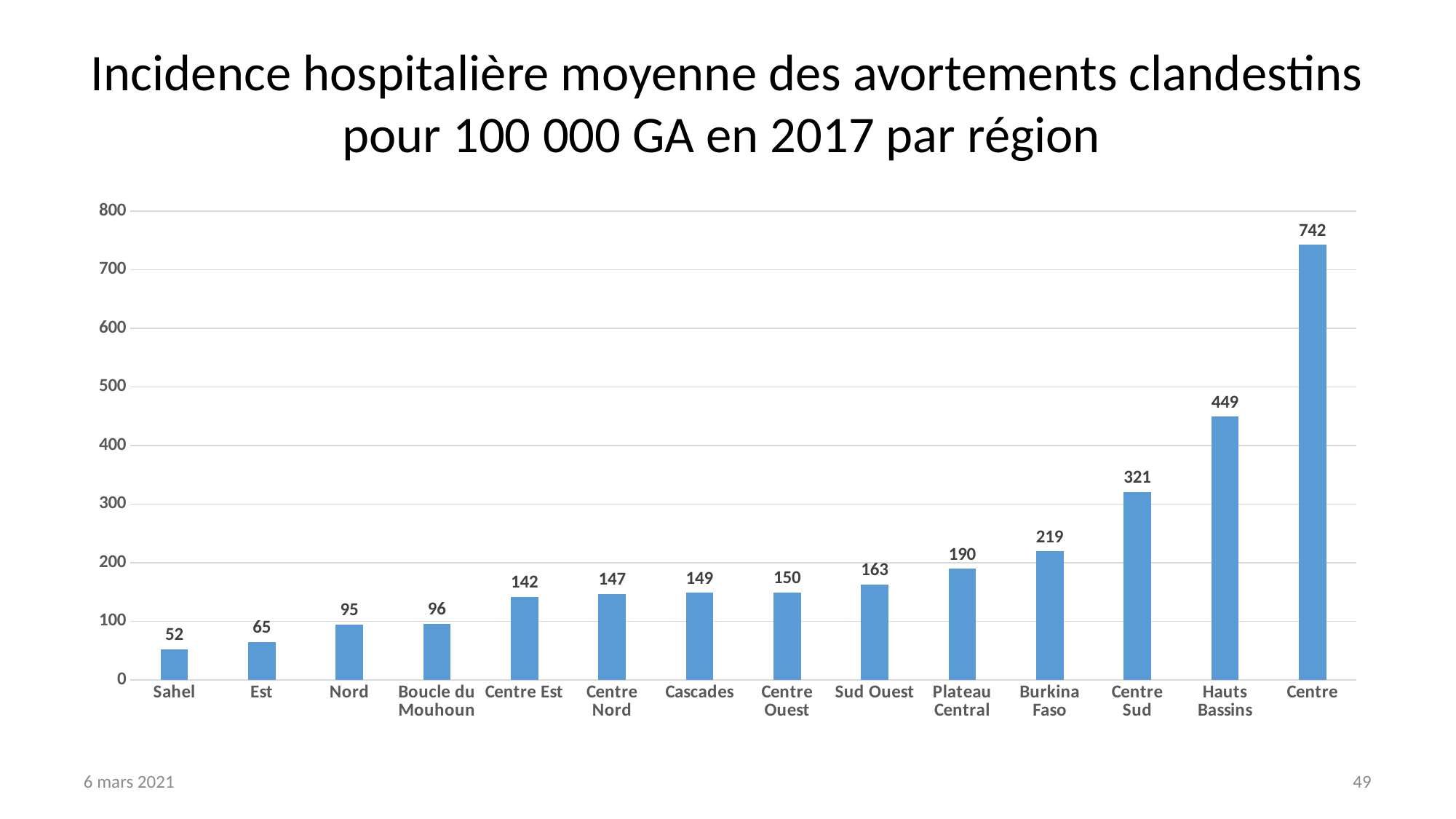
Which is larger, the value for Plateau Central or the value for Sud Ouest? Plateau Central What is the value for Boucle du Mouhoun? 96 How many regions are shown on the x axis? 14 What is the difference between the values for Centre and Hauts Bassins? 293 What kind of chart is this? bar chart Which region has the highest value? Centre What is the value for Centre? 742 What is the value for Burkina Faso? 219 Which region has the lowest value? Sahel Do the values rise or fall from left to right along the x axis? rise Is the value for Hauts Bassins greater or less than 400? greater What is the difference between the values for Centre Sud and Burkina Faso? 102